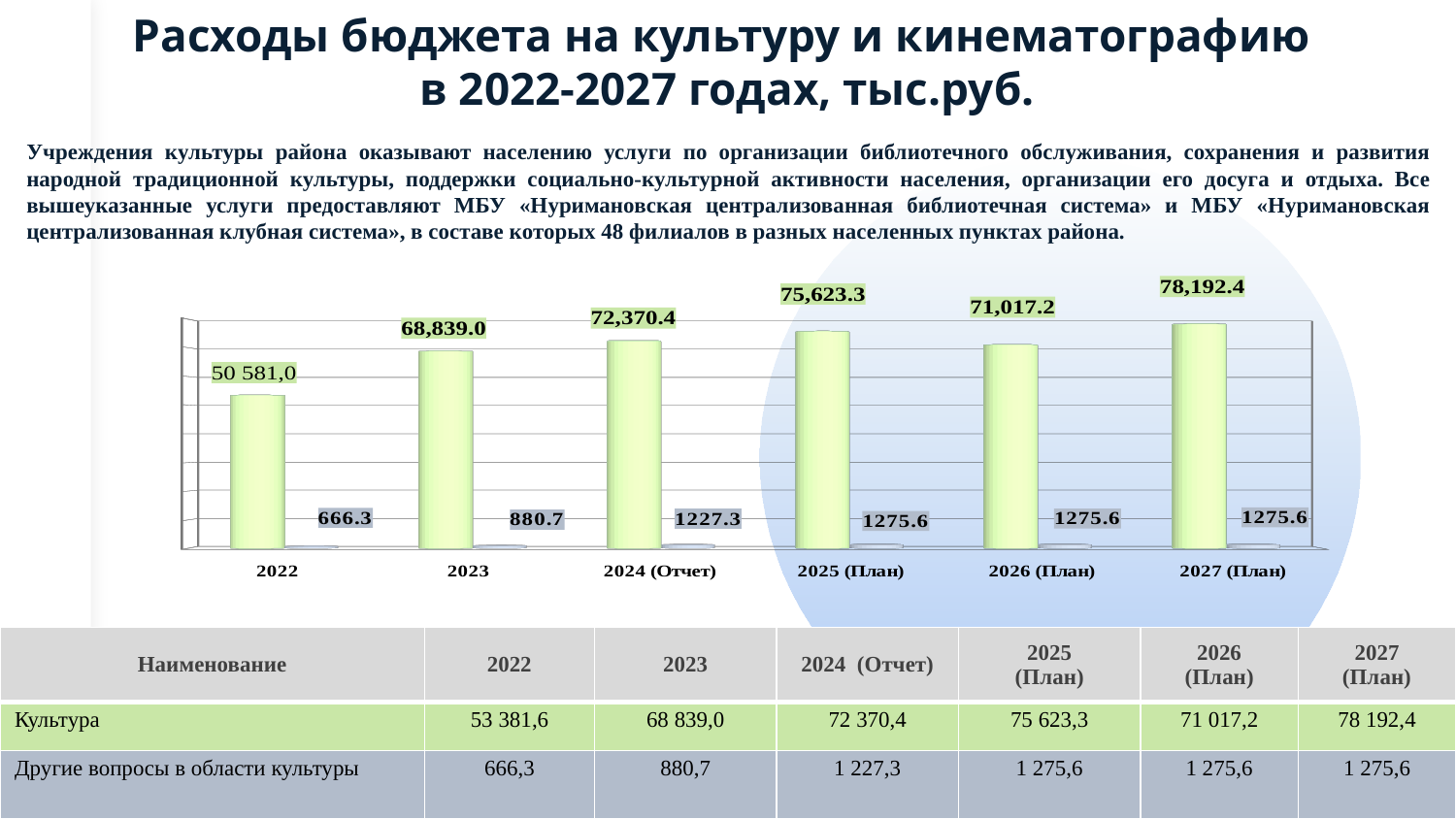
What is the data label on the small bar for 2022 in the chart? 666.3 What type of chart is shown on the slide? bar chart What is the data label on the tall bar for 2023 in the chart? 68,839.0 What is the difference between the tall bar values for 2027 (План) and 2026 (План) in the chart? 7,175.2 What is the data label on the small bar for 2024 (Отчет) in the chart? 1227.3 Which year has the lowest tall bar in the chart? 2022 Is the tall bar for 2025 (План) larger or smaller than the tall bar for 2026 (План)? larger Which year has the highest tall bar in the chart? 2027 (План) What is the data label on the tall bar for 2024 (Отчет) in the chart? 72,370.4 What is the data label on the tall bar for 2026 (План) in the chart? 71,017.2 How many year categories are shown along the x axis of the chart? 6 Do the small bar values rise or fall from 2022 to 2024 (Отчет) in the chart? rise